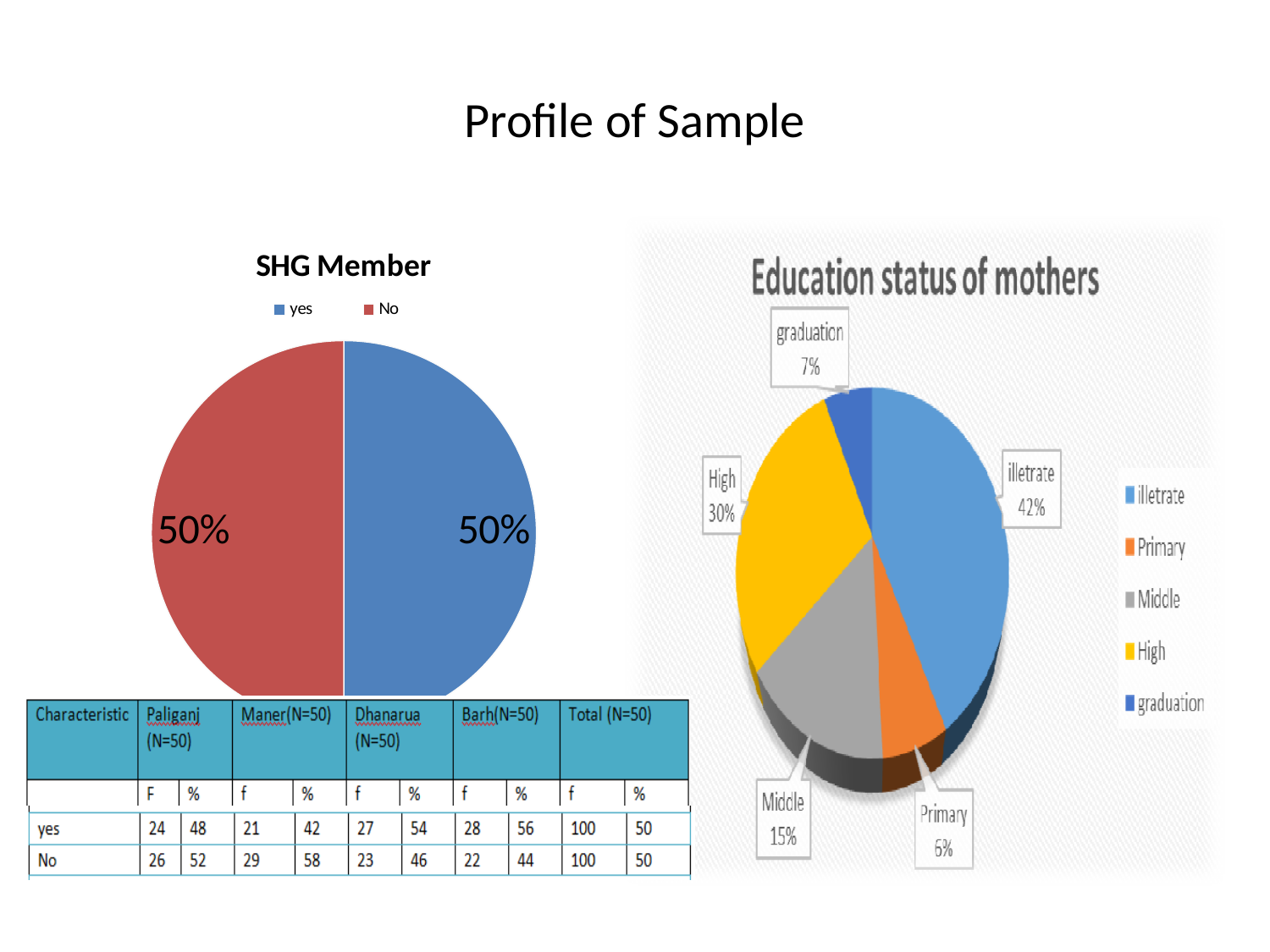
In the 'Education status of mothers' chart, which category has the largest slice? illetrate How many entries does the legend of the 'SHG Member' chart list? 2 In the 'Education status of mothers' chart, what percentage is shown for 'illetrate'? 42% In the 'SHG Member' chart, what share of the pie is labelled 'yes'? 50% In the 'Education status of mothers' chart, what is the difference in percentage points between 'illetrate' and 'High'? 12 In the 'Education status of mothers' chart, which category has the smallest slice? Primary In the 'Education status of mothers' chart, what percentage is shown for 'Middle'? 15% How many categories does the 'Education status of mothers' chart show? 5 In the 'Education status of mothers' chart, which is larger, 'graduation' or 'Primary'? graduation What kind of chart is the 'SHG Member' chart? Pie chart In the 'Education status of mothers' chart, what percentage is shown for 'High'? 30% In the 'SHG Member' chart, what share of the pie is labelled 'No'? 50%